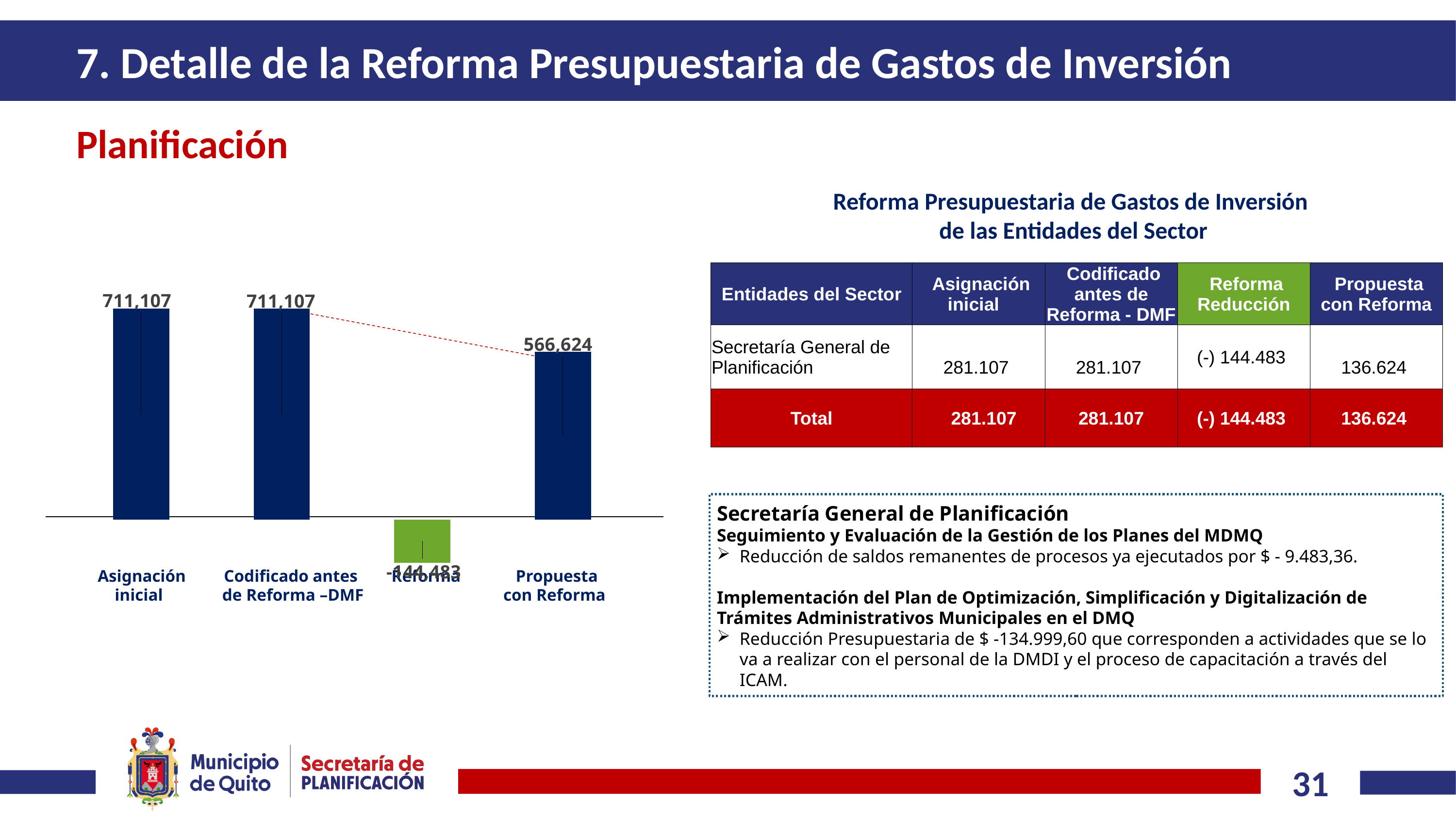
Which category in the chart has the lowest value? Reforma What is the difference between the Codificado antes de Reforma –DMF value and the Propuesta con Reforma value in the chart? 144,483 What kind of chart is shown on the slide? Bar chart What is the value shown for Reforma in the chart? -144,483 What is the value shown for Propuesta con Reforma in the chart? 566,624 What is the value shown for Asignación inicial in the chart? 711,107 Which category in the chart is drawn as a green bar? Reforma Which bar in the chart extends below the horizontal axis? Reforma How many categories are shown on the x axis of the chart? 4 What is the value shown for Codificado antes de Reforma –DMF in the chart? 711,107 Which is larger in the chart, Asignación inicial or Propuesta con Reforma? Asignación inicial Is the value for Propuesta con Reforma in the chart greater or less than the value for Codificado antes de Reforma –DMF? less